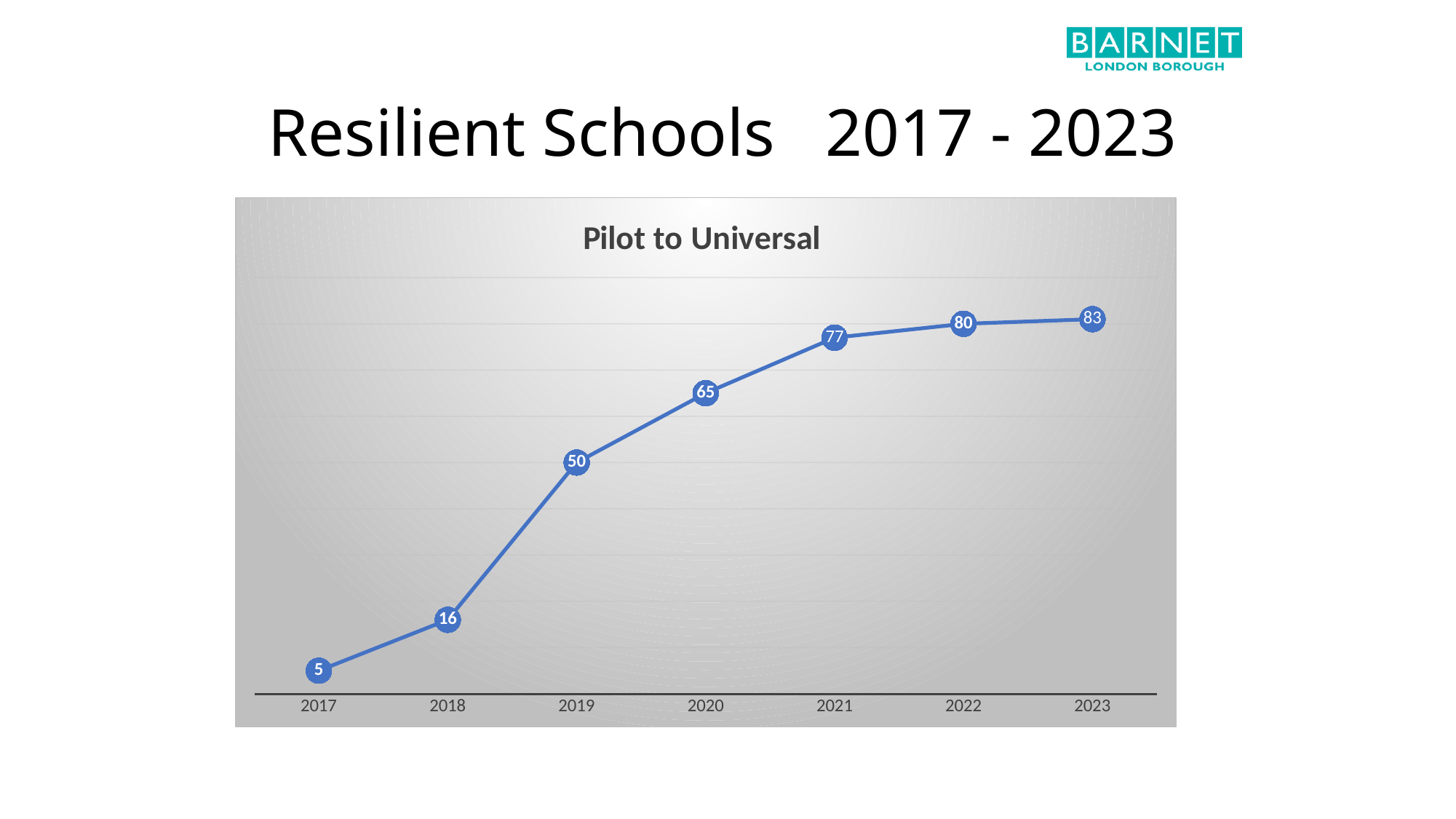
What is the value for 2019? 50 What is the value for 2021? 77 Which is larger, the value for 2020 or the value for 2022? 2022 What is the value for 2023? 83 What is the value for 2017? 5 What is the difference between the values for 2019 and 2018? 34 Do the values rise or fall from 2017 to 2023? Rise Which year has the highest value? 2023 What kind of chart is shown? Line chart How many data points are plotted on the chart? 7 Which year has the lowest value? 2017 What is the difference between the values for 2023 and 2017? 78